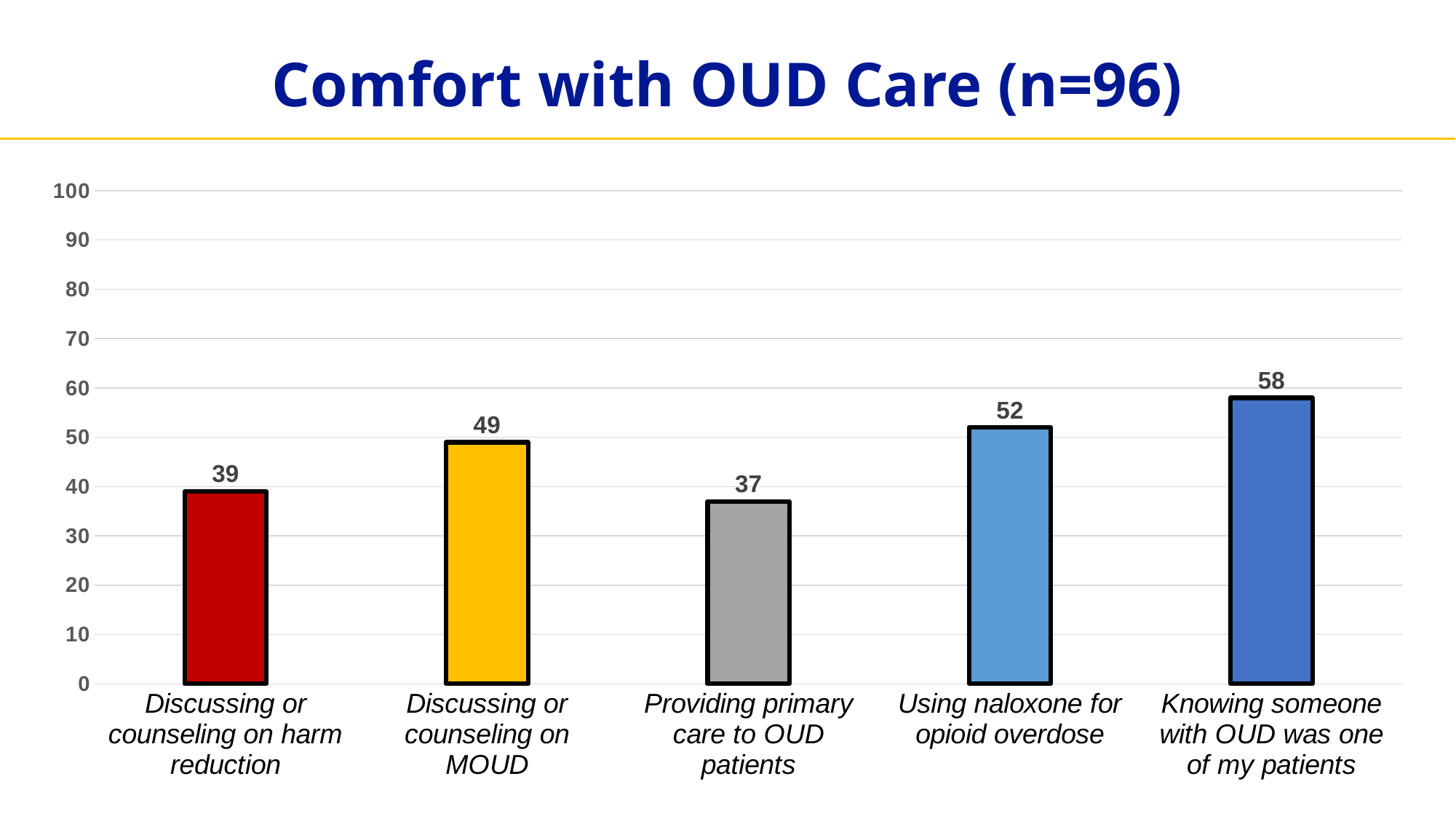
Which is larger: the value for "Discussing or counseling on MOUD" or the value for "Using naloxone for opioid overdose"? Using naloxone for opioid overdose What is the difference between the values for "Knowing someone with OUD was one of my patients" and "Discussing or counseling on harm reduction"? 19 What is the value for "Using naloxone for opioid overdose"? 52 What is the title of the chart? Comfort with OUD Care (n=96) What is the difference between the values for "Discussing or counseling on MOUD" and "Providing primary care to OUD patients"? 12 What is the value for "Providing primary care to OUD patients"? 37 Which category has the highest value? Knowing someone with OUD was one of my patients How many categories are shown in the chart? 5 Which category has the lowest value? Providing primary care to OUD patients Is the value for "Knowing someone with OUD was one of my patients" greater or less than 50? greater What kind of chart is shown on the slide? Bar chart What is the value for "Discussing or counseling on harm reduction"? 39